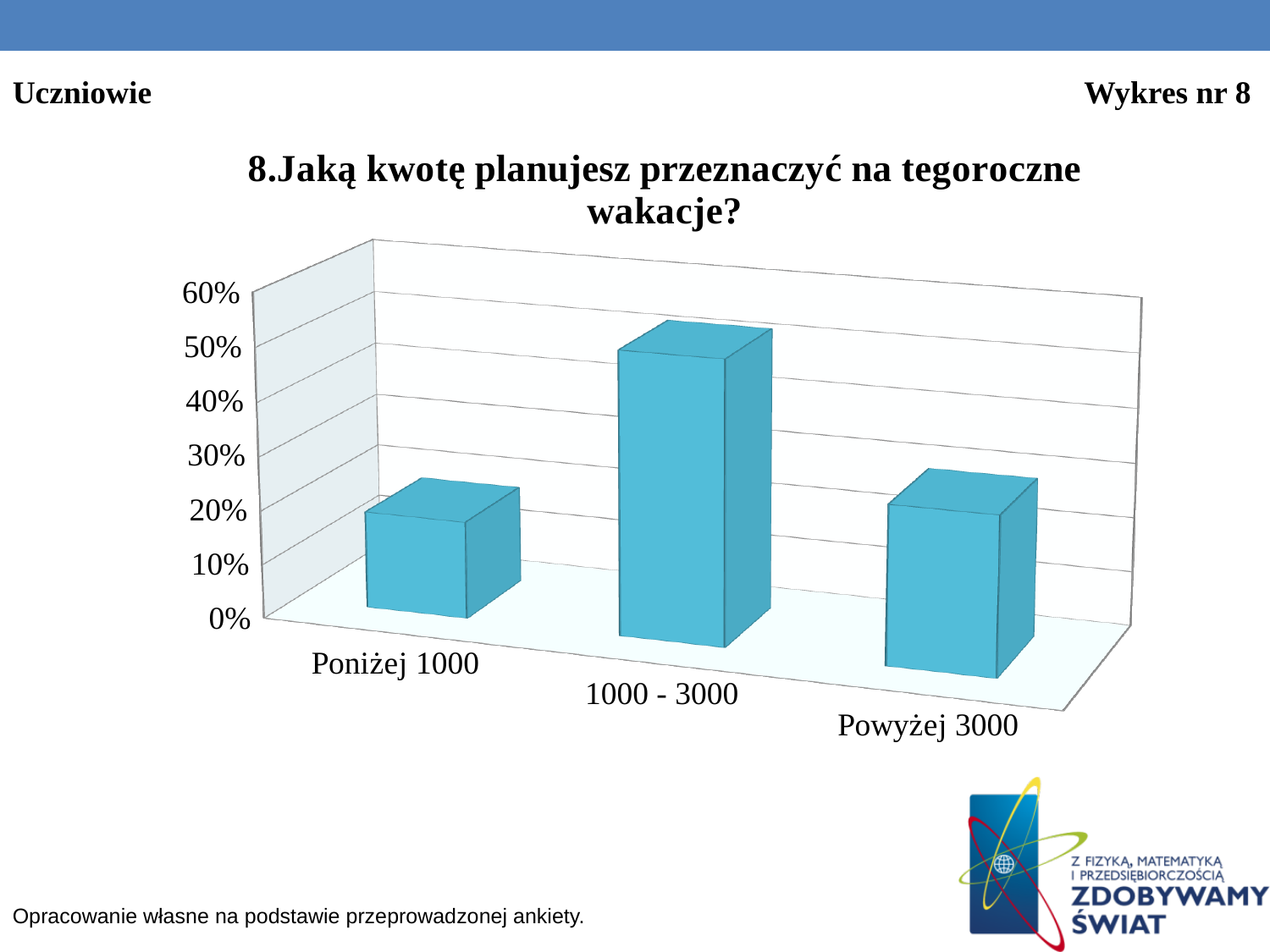
What is the highest value shown on the vertical axis of the chart? 60% What is the title of the chart? 8.Jaką kwotę planujesz przeznaczyć na tegoroczne wakacje? Is the value for Poniżej 1000 greater or less than 30%? less Is the value for 1000 - 3000 greater or less than 40%? greater What kind of chart is shown on the slide? bar chart Is the value for Powyżej 3000 greater or less than 40%? less Which category has the lowest value in the chart? Poniżej 1000 Which is larger, the value for Poniżej 1000 or the value for Powyżej 3000? Powyżej 3000 Which is larger, the value for 1000 - 3000 or the value for Powyżej 3000? 1000 - 3000 Which category has the highest value in the chart? 1000 - 3000 How many categories are shown on the x axis of the chart? 3